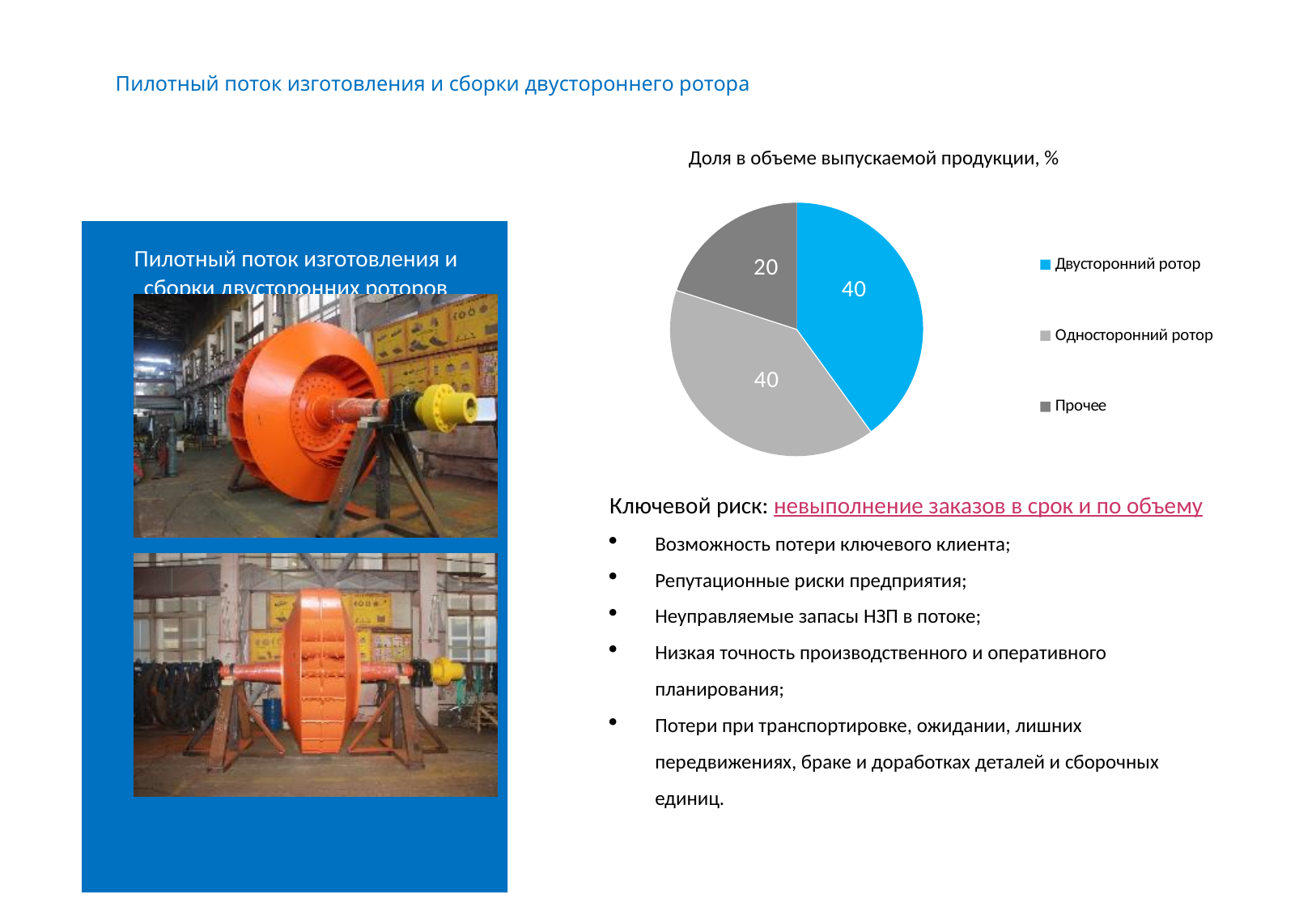
What share of the pie does Прочее represent? 20% How many slices does the pie chart have? 3 What is the value shown for Прочее in the pie chart? 20 Which is larger, the value for Односторонний ротор or the value for Прочее? Односторонний ротор How many entries does the legend of the pie chart list? 3 What kind of chart is shown on the slide? Pie chart What is the difference between the values for Двусторонний ротор and Прочее? 20 What is the value shown for Двусторонний ротор in the pie chart? 40 Which category is shown in bright blue in the pie chart? Двусторонний ротор What is the value shown for Односторонний ротор in the pie chart? 40 Which category has the smallest slice in the pie chart? Прочее What is the title of the pie chart? Доля в объеме выпускаемой продукции, %